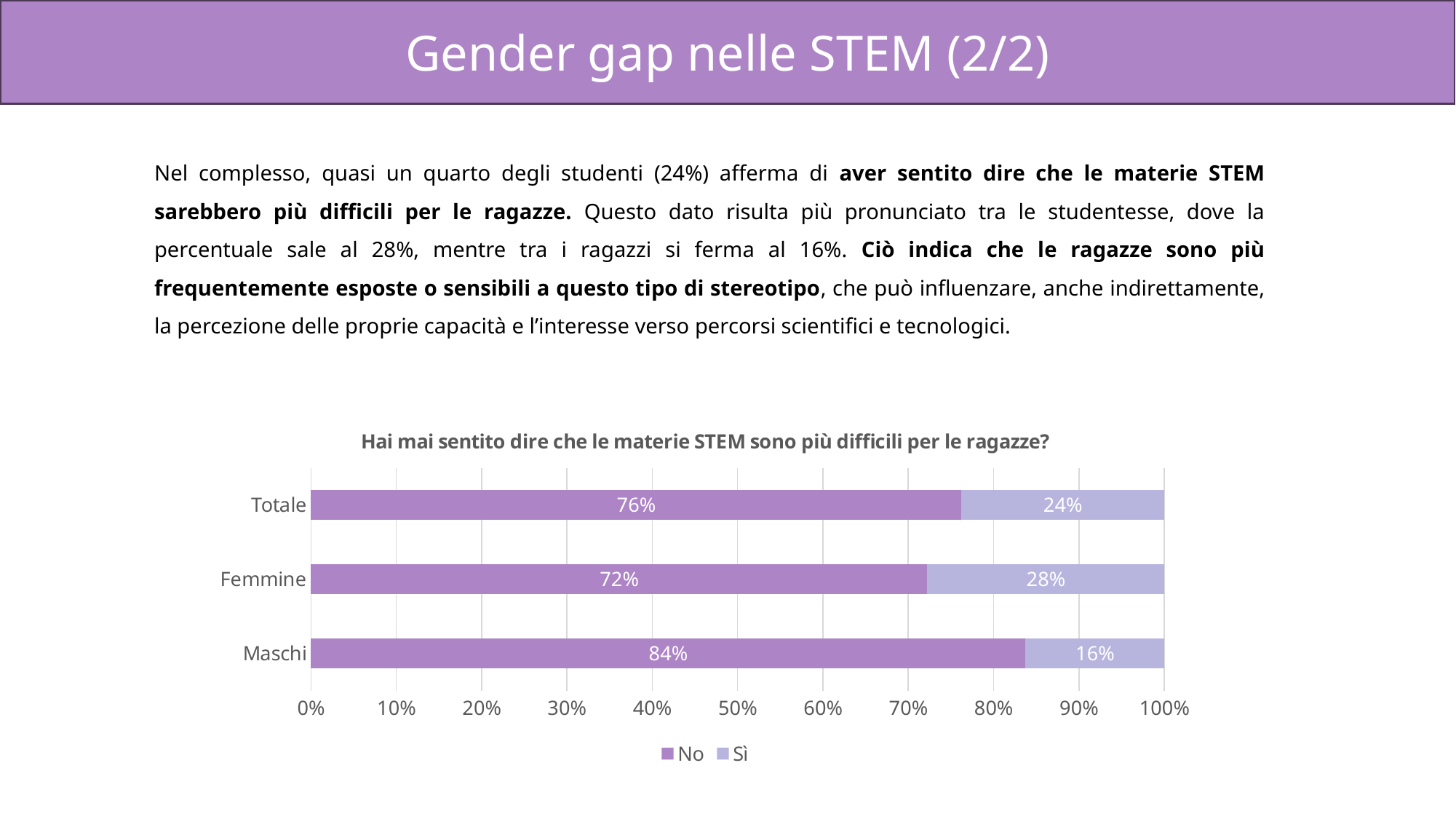
What kind of chart is shown on the slide? Stacked bar chart What is the difference in percentage points between the "Sì" values for Femmine and Maschi? 12 How many categories are shown on the chart? 3 Which category has the lowest "No" percentage? Femmine How many series does the legend list? 2 What percentage of Femmine answered "Sì"? 28% What percentage of Maschi answered "No"? 84% What is the total of the stacked bar for Femmine? 100% What is the "Sì" value for Totale? 24% What is the title of the chart? Hai mai sentito dire che le materie STEM sono più difficili per le ragazze? Which is larger: the "No" value for Totale or the "No" value for Maschi? Maschi Which category has the highest "Sì" percentage? Femmine